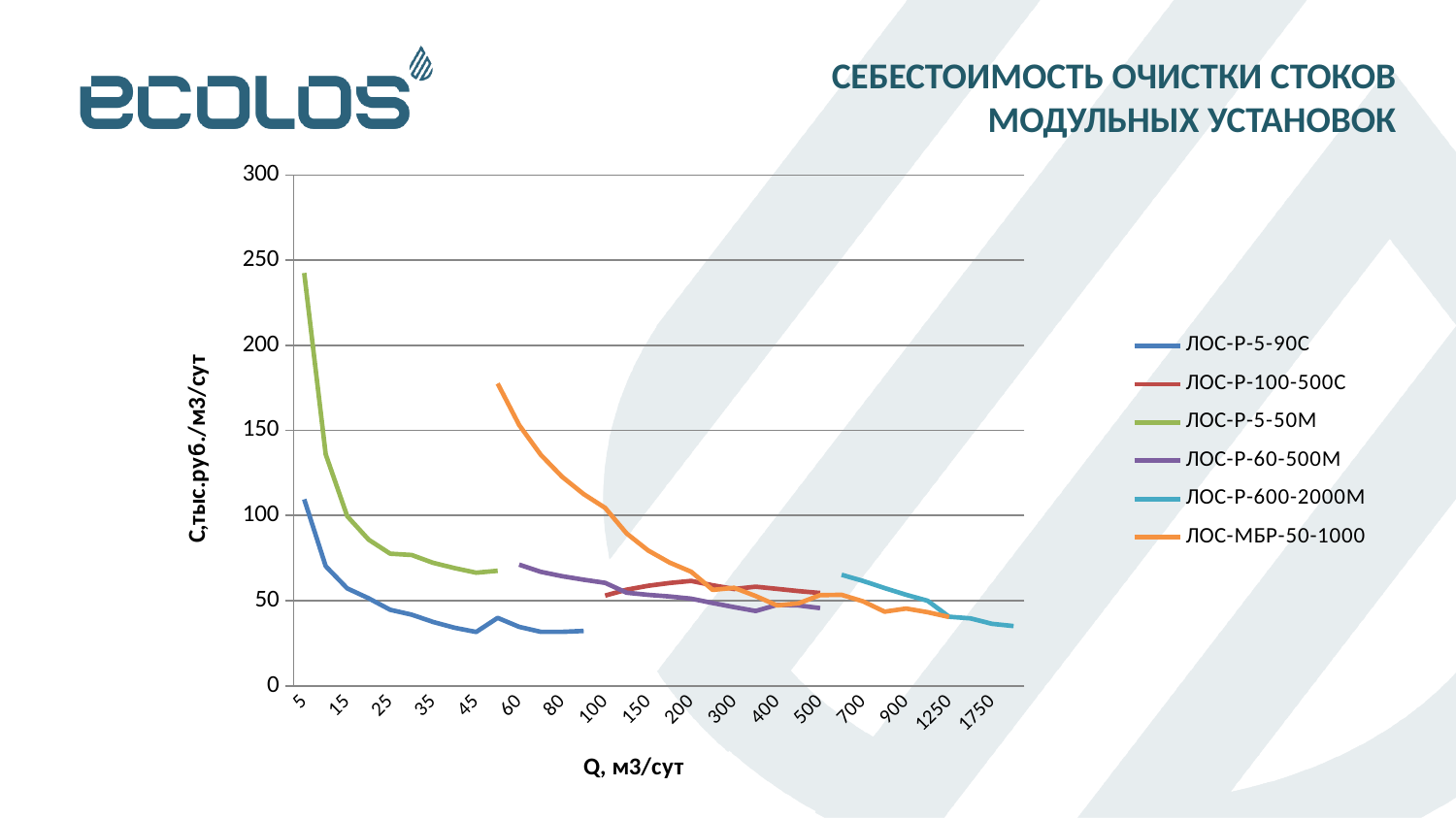
Is the value for ЛОС-Р-600-2000М at Q = 1750 greater or less than 50? less How many tick labels are shown along the x axis (Q, м3/сут)? 17 Which series reaches the highest value on the chart? ЛОС-Р-5-50М Is the value for ЛОС-Р-5-50М at Q = 5 greater or less than 200? greater How many series does the legend list? 6 What kind of chart is shown on the slide? line chart At Q = 5, which series has the higher value: ЛОС-Р-5-50М or ЛОС-Р-5-90С? ЛОС-Р-5-50М Does the ЛОС-Р-5-50М line rise or fall as Q increases? fall Which series is drawn in green in the legend? ЛОС-Р-5-50М What is the label of the y axis? С,тыс.руб./м3/сут Is the value for ЛОС-Р-60-500М at Q = 60 greater or less than 50? greater